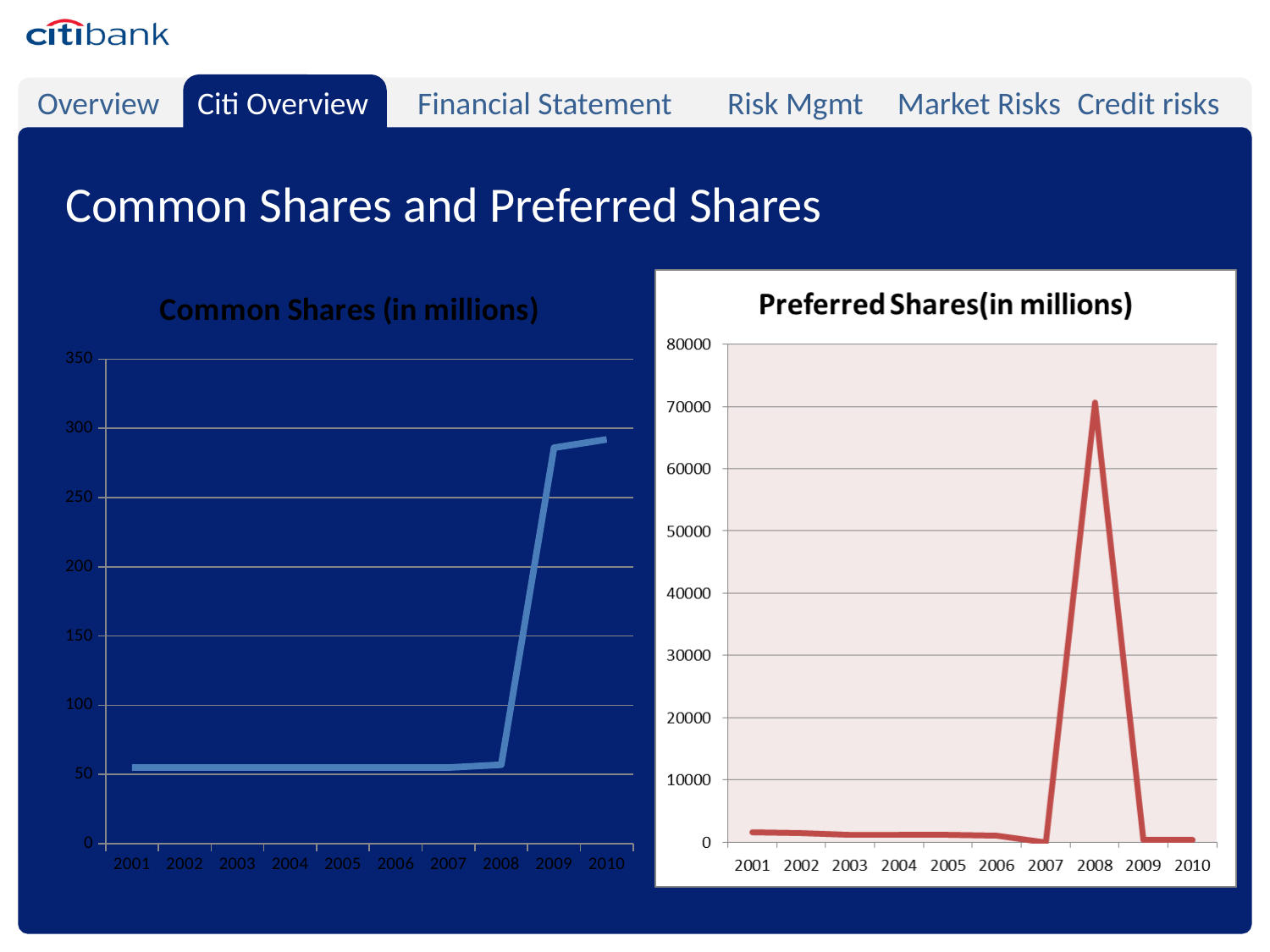
In the Common Shares (in millions) chart, do values rise or fall from 2008 to 2009? rise In the Preferred Shares (in millions) chart, is the value for 2008 greater or less than 60000? greater How many years are shown on the x axis of the Preferred Shares (in millions) chart? 10 How many years are shown on the x axis of the Common Shares (in millions) chart? 10 What kind of chart is the Common Shares (in millions) chart? line chart In the Preferred Shares (in millions) chart, which year has the highest value? 2008 In the Common Shares (in millions) chart, is the value for 2009 greater or less than 250? greater In the Common Shares (in millions) chart, which is larger, the value for 2005 or the value for 2009? 2009 In the Preferred Shares (in millions) chart, do values rise or fall from 2008 to 2009? fall In the Preferred Shares (in millions) chart, is the value for 2001 greater or less than 10000? less What kind of chart is the Preferred Shares (in millions) chart? line chart